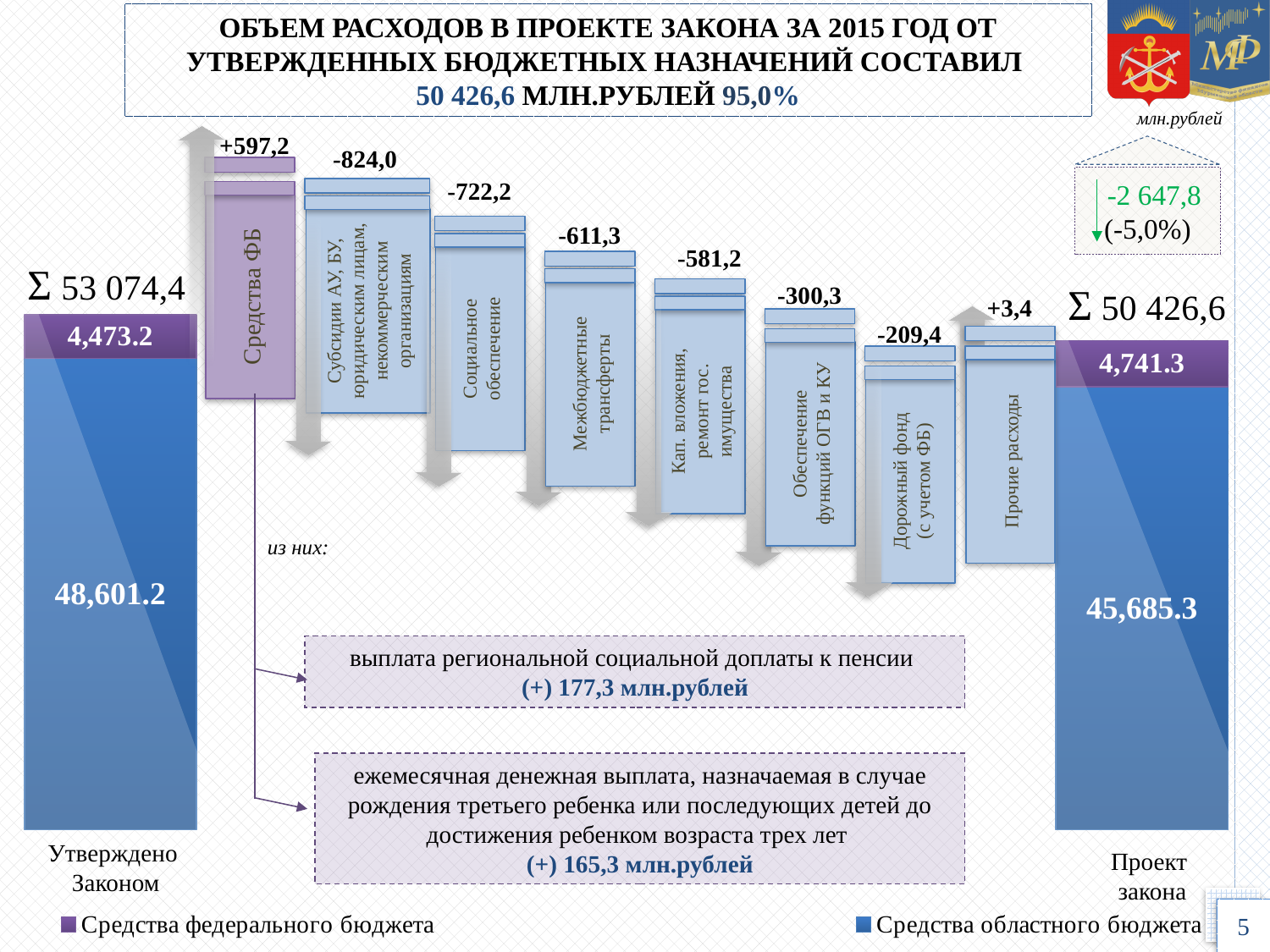
Which step in the waterfall chart shows the largest decrease? Субсидии АУ, БУ, юридическим лицам, некоммерческим организациям (-824,0) How many series does the legend list? 2 What is the total of the "Утверждено Законом" stacked bar? 53 074,4 What is the difference between "Средства областного бюджета" in the "Утверждено Законом" bar and in the "Проект закона" bar? 2,915.9 What is the value shown for "Дорожный фонд (с учетом ФБ)"? -209,4 What is the value shown for "Социальное обеспечение"? -722,2 How many intermediate steps are shown between the "Утверждено Законом" and "Проект закона" bars? 8 What is the total of the "Проект закона" stacked bar? 50 426,6 What is the value of "Средства федерального бюджета" in the "Утверждено Законом" bar? 4,473.2 What is the value shown for the "Средства ФБ" step in the waterfall chart? +597,2 Is "Средства федерального бюджета" larger in the "Утверждено Законом" bar or in the "Проект закона" bar? Проект закона What is the value of "Средства областного бюджета" in the "Проект закона" bar? 45,685.3